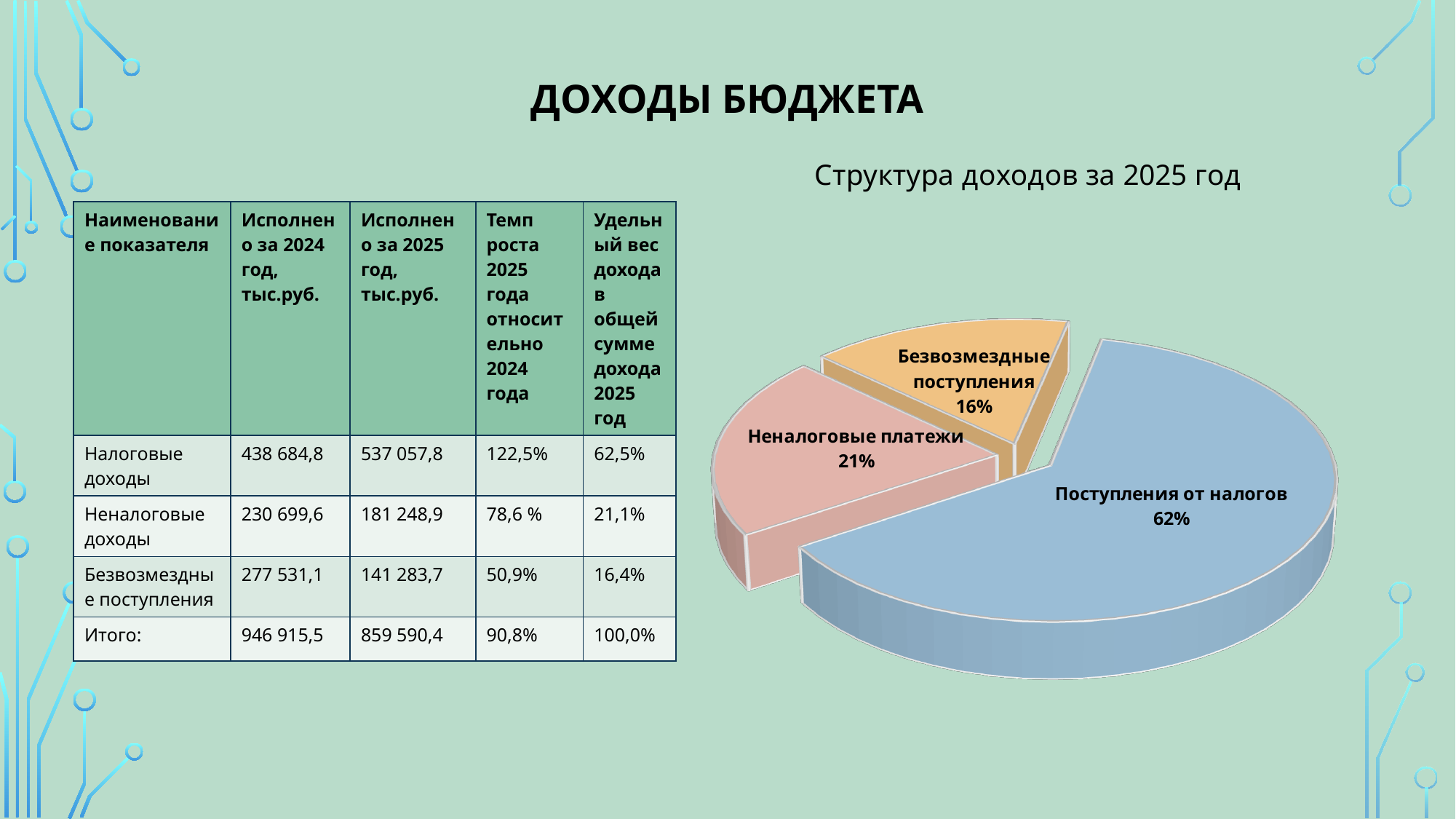
Which is larger in the pie chart: "Неналоговые платежи" or "Безвозмездные поступления"? Неналоговые платежи What share of the pie is labelled "Безвозмездные поступления"? 16% What share of the pie is labelled "Поступления от налогов"? 62% What is the difference in percentage points between "Поступления от налогов" and "Неналоговые платежи"? 41% What kind of chart is shown on the slide? Pie chart What colour is the "Поступления от налогов" slice in the pie chart? Blue What is the title of the pie chart? Структура доходов за 2025 год How many slices does the pie chart have? 3 What share of the pie is labelled "Неналоговые платежи"? 21% Which slice of the pie chart is the smallest? Безвозмездные поступления What is the difference in percentage points between "Неналоговые платежи" and "Безвозмездные поступления"? 5% Which slice of the pie chart is the largest? Поступления от налогов